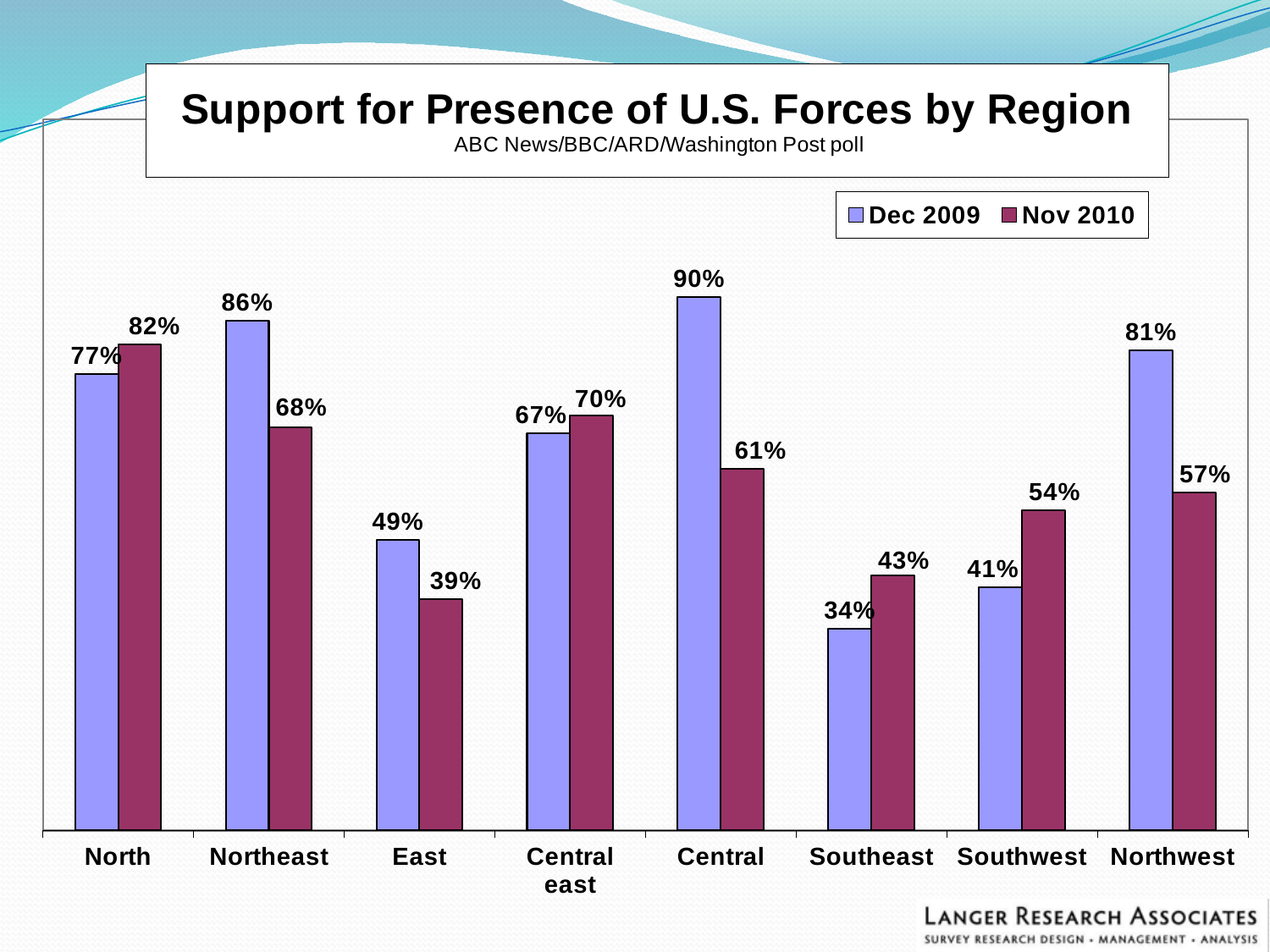
Which poll is cited in the chart subtitle? ABC News/BBC/ARD/Washington Post poll What is the difference between the Dec 2009 and Nov 2010 values for Central? 29% What is the Dec 2009 value for Central? 90% What is the Nov 2010 value for East? 39% What is the title of the chart? Support for Presence of U.S. Forces by Region Which is larger for Southwest, the Dec 2009 value or the Nov 2010 value? Nov 2010 What is the Nov 2010 value for Northwest? 57% How many series does the legend list? 2 Which region has the lowest Nov 2010 value? East How many regions are shown on the x axis? 8 What kind of chart is shown on the slide? Bar chart Which region has the highest Dec 2009 value? Central